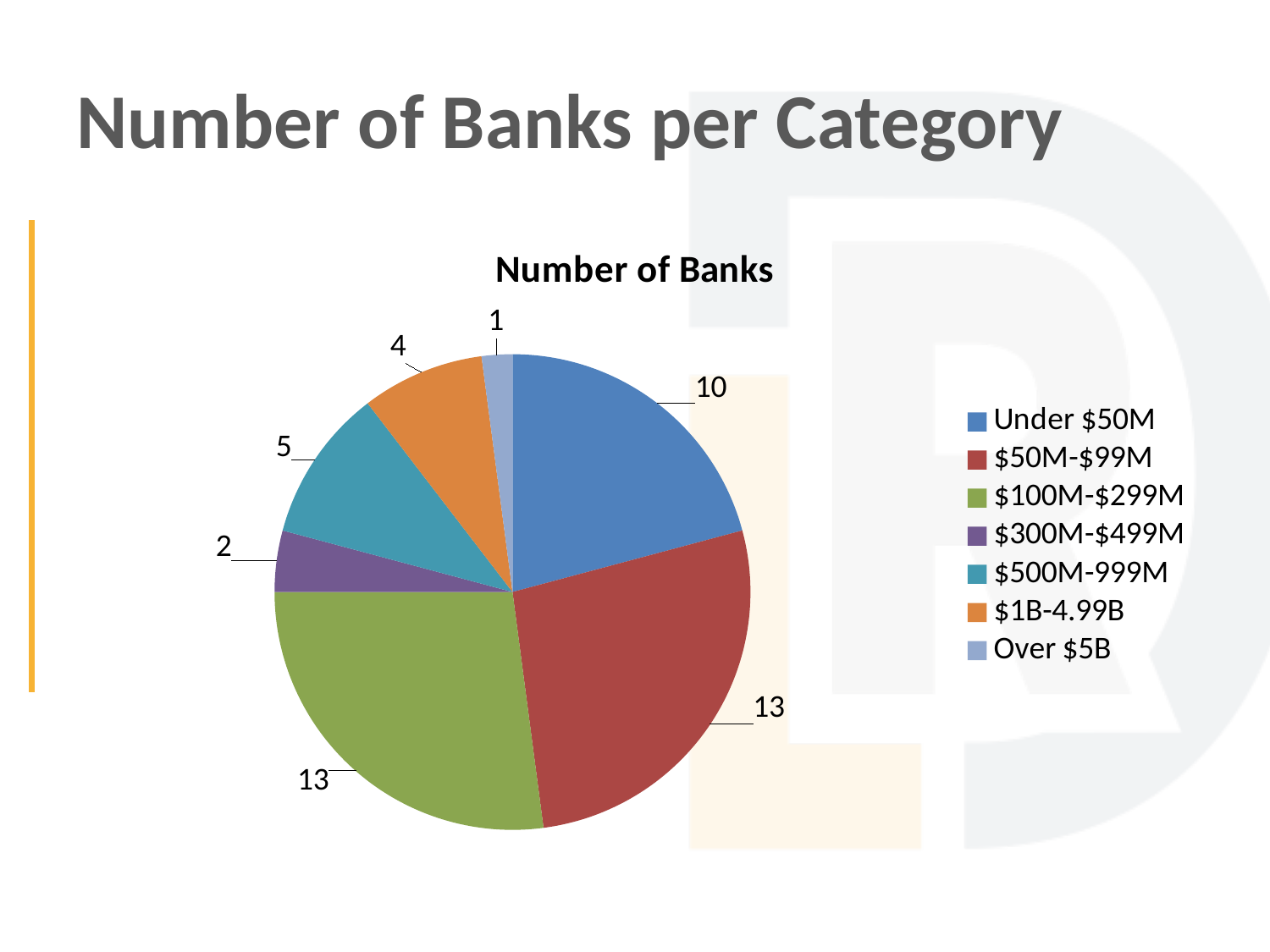
How many banks are in the Under $50M category? 10 How many banks are in the $300M-$499M category? 2 What is the difference between the number of banks in the $50M-$99M category and the Under $50M category? 3 How many banks are in the $500M-999M category? 5 How many banks are in the $1B-4.99B category? 4 How many categories does the legend list? 7 What type of chart is shown on the slide? Pie chart What is the title of the chart? Number of Banks Which category has more banks, $500M-999M or $1B-4.99B? $500M-999M Which category has the fewest banks? Over $5B Which colour represents the $100M-$299M category in the pie chart? Green What is the total number of banks across all categories in the pie chart? 48